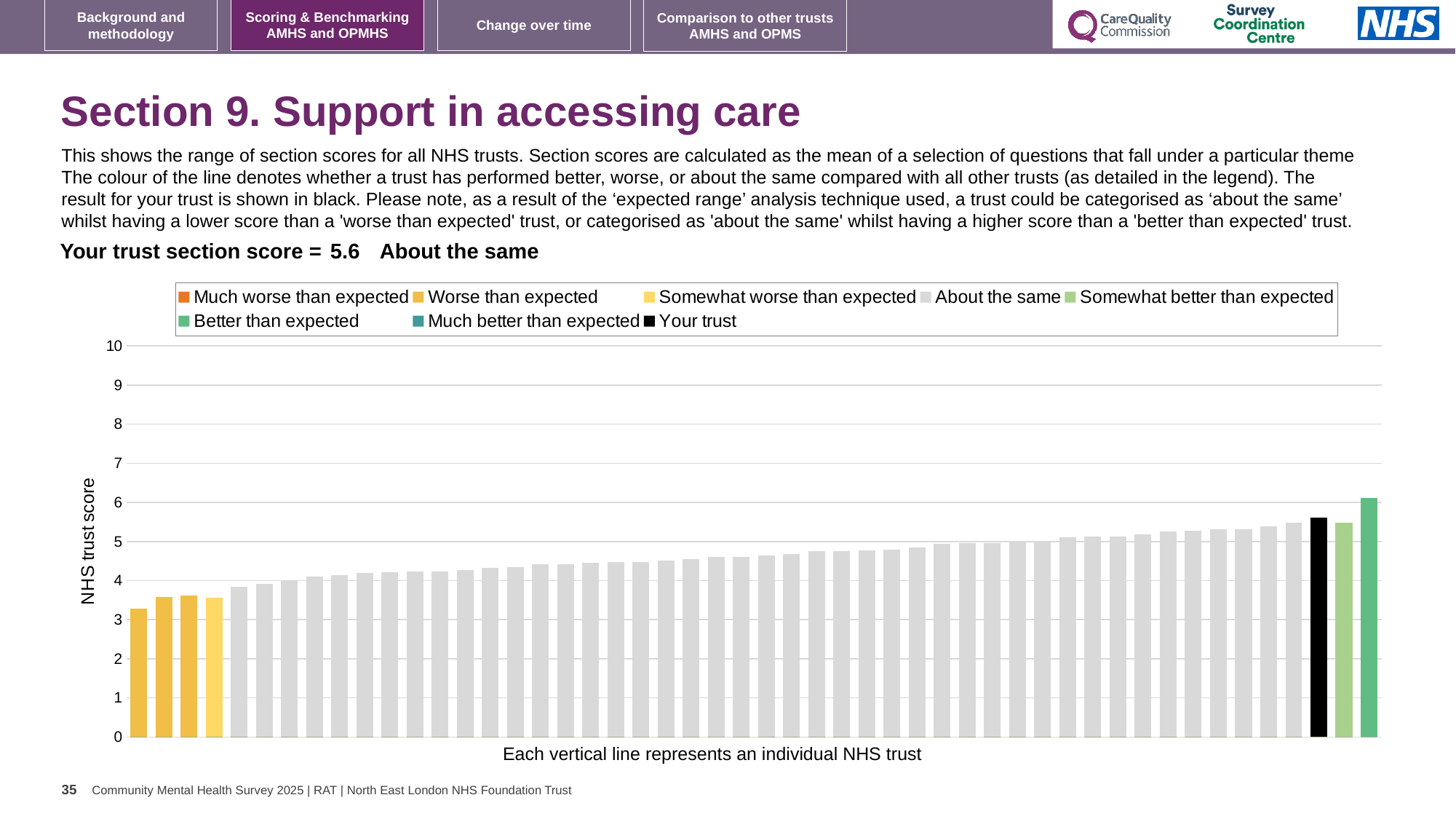
Which legend category does the tallest bar belong to? Better than expected Which category is your trust placed in for this section, according to the slide? About the same What colour is used for the bar representing your trust? black Do the bar values rise or fall from left to right along the x axis? rise Is the value of the tallest bar greater or less than 7? less Is the value for your trust (the black bar) greater or less than 5? greater What is the section score for your trust, as stated on the slide? 5.6 What kind of chart is shown on the slide? bar chart Is the value of the leftmost bar greater or less than 4? less How many entries does the chart legend list? 8 Which is taller, the black bar for your trust or the rightmost bar? the rightmost bar What is the label on the vertical axis of the chart? NHS trust score